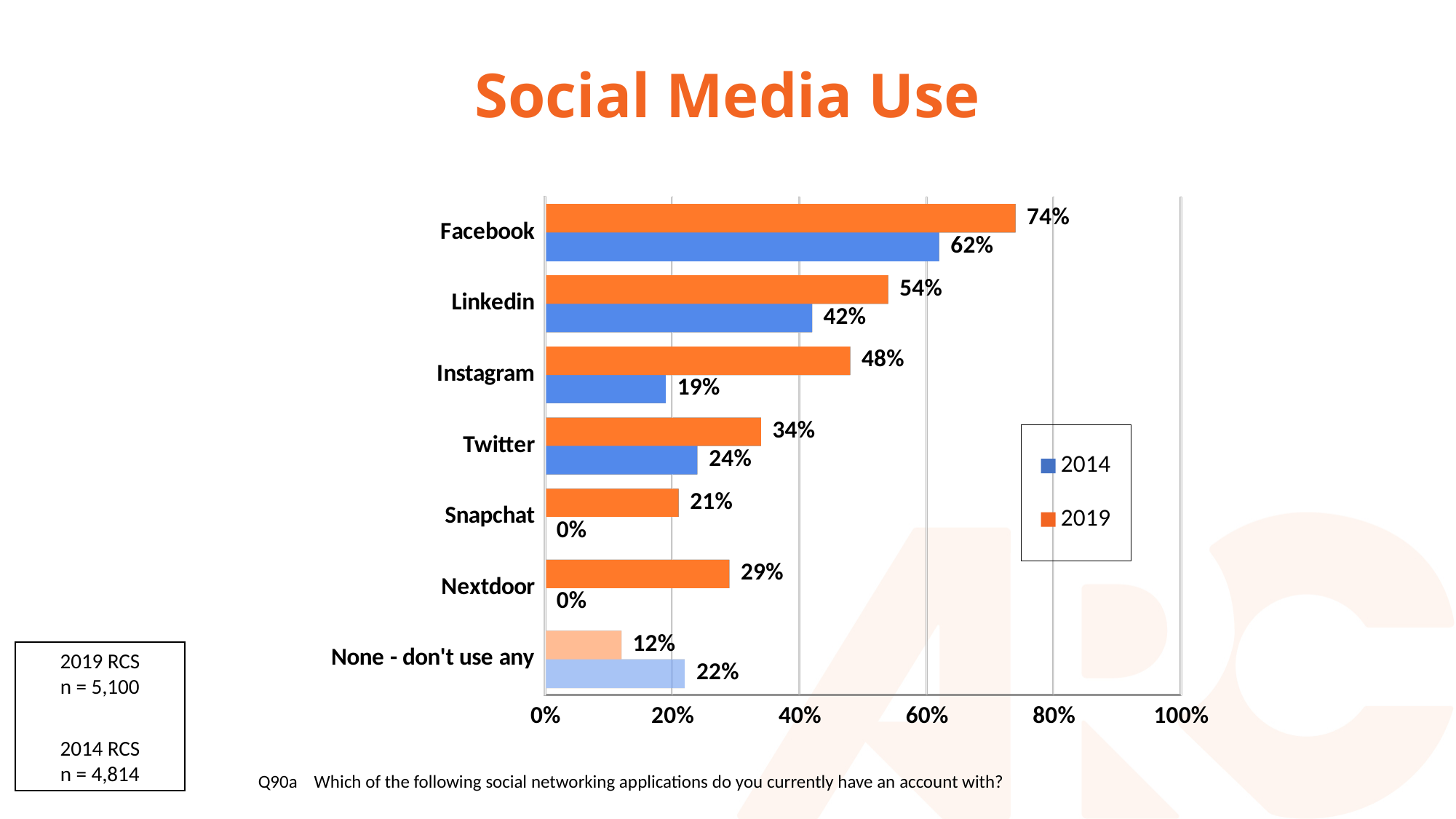
What is the title of the slide? Social Media Use How many series does the legend list? 2 Which category has the lowest 2019 value? None - don't use any What is the 2019 value for Facebook? 74% Which category has the highest 2019 value? Facebook What is the 2019 value for Nextdoor? 29% What is the 2014 value for Instagram? 19% How many categories are shown on the chart? 7 Which is larger, the 2019 value for Twitter or the 2019 value for Nextdoor? Twitter What is the difference between the 2019 and 2014 values for Linkedin? 12% What is the difference between the 2019 and 2014 values for Instagram? 29% What kind of chart is shown on the slide? Bar chart